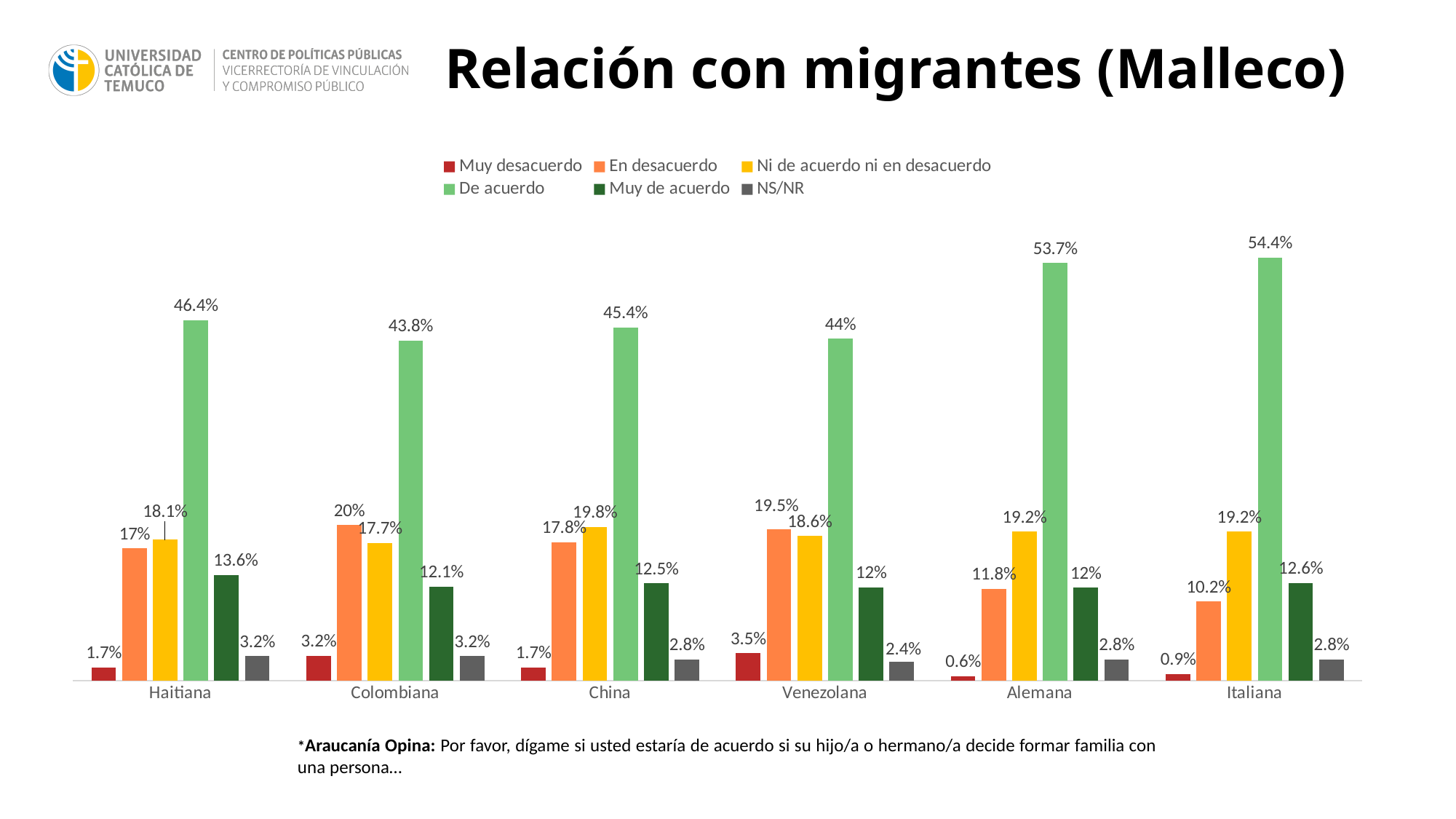
Which category has the lowest value for "En desacuerdo"? Italiana Which is larger: the "Muy desacuerdo" value for Venezolana or for Colombiana? Venezolana What is the value for "De acuerdo" for Italiana? 54.4% What is the value for "Muy desacuerdo" for Alemana? 0.6% What is the value for "Muy de acuerdo" for Haitiana? 13.6% Which category has the highest value for "De acuerdo"? Italiana What is the difference between the "De acuerdo" values for Alemana and Haitiana? 7.3% What is the value for "En desacuerdo" for Colombiana? 20% How many categories are shown on the x axis? 6 What kind of chart is shown on the slide? Bar chart What is the title of the slide? Relación con migrantes (Malleco) How many series does the legend list? 6